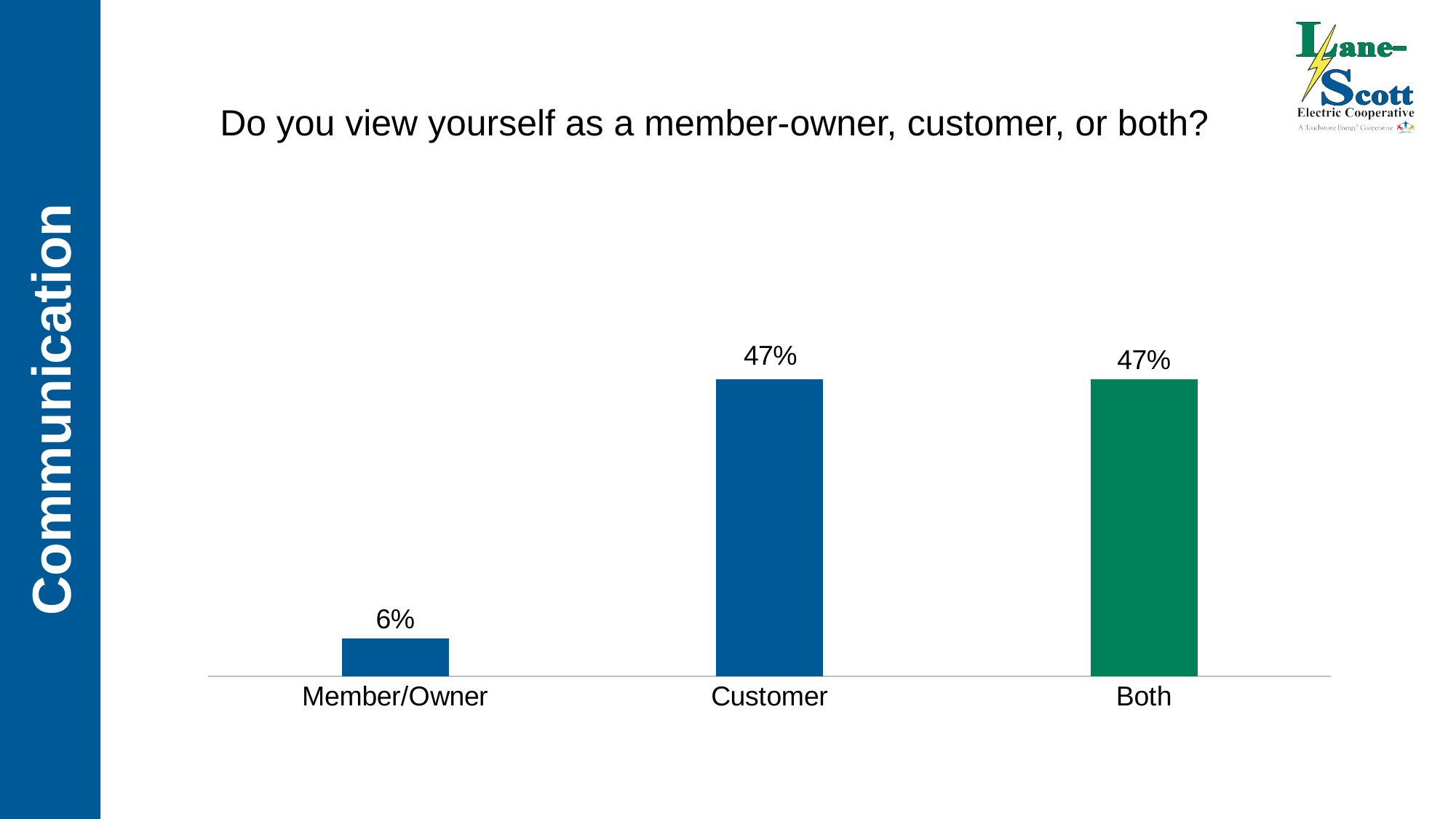
Which category has the lowest value? Member/Owner What question does the chart title ask? Do you view yourself as a member-owner, customer, or both? What is the total of the Customer and Both values? 94% What is the difference between the Customer value and the Member/Owner value? 41% What percentage of respondents view themselves as Customer? 47% What percentage of respondents view themselves as Both? 47% What kind of chart is shown on the slide? Bar chart How many categories are shown on the chart? 3 Which is larger, the value for Member/Owner or the value for Both? Both Which category's bar is coloured green? Both What percentage of respondents view themselves as Member/Owner? 6%